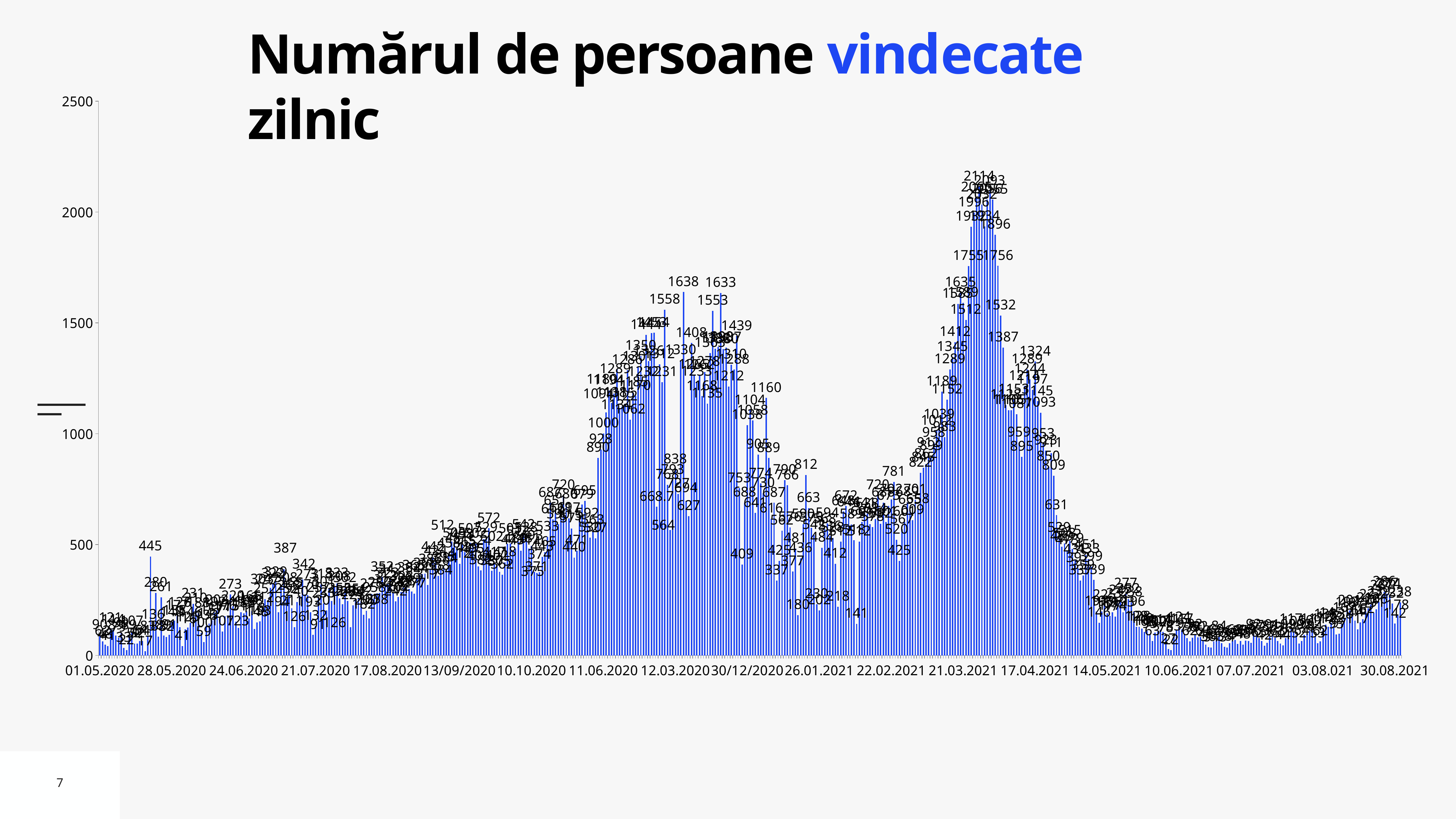
What is the difference between the highest labelled value, 2114, and the labelled value 1638? 476 What kind of chart is shown on the slide? bar chart Is the value for 17.04.2021 greater or less than 1000? greater What is the highest tick value shown on the vertical axis? 2500 Is the value for 30.08.2021 greater or less than 500? less Do the values rise or fall between 14.05.2021 and 10.06.2021? fall Is the value for 10.06.2021 greater or less than 500? less What value is labelled on the tall isolated bar just before 28.05.2020? 445 What is the highest value labelled on the chart? 2114 Is the tallest bar of the chart located in 2020 or in 2021? 2021 What is the title of the chart? Numărul de persoane vindecate zilnic